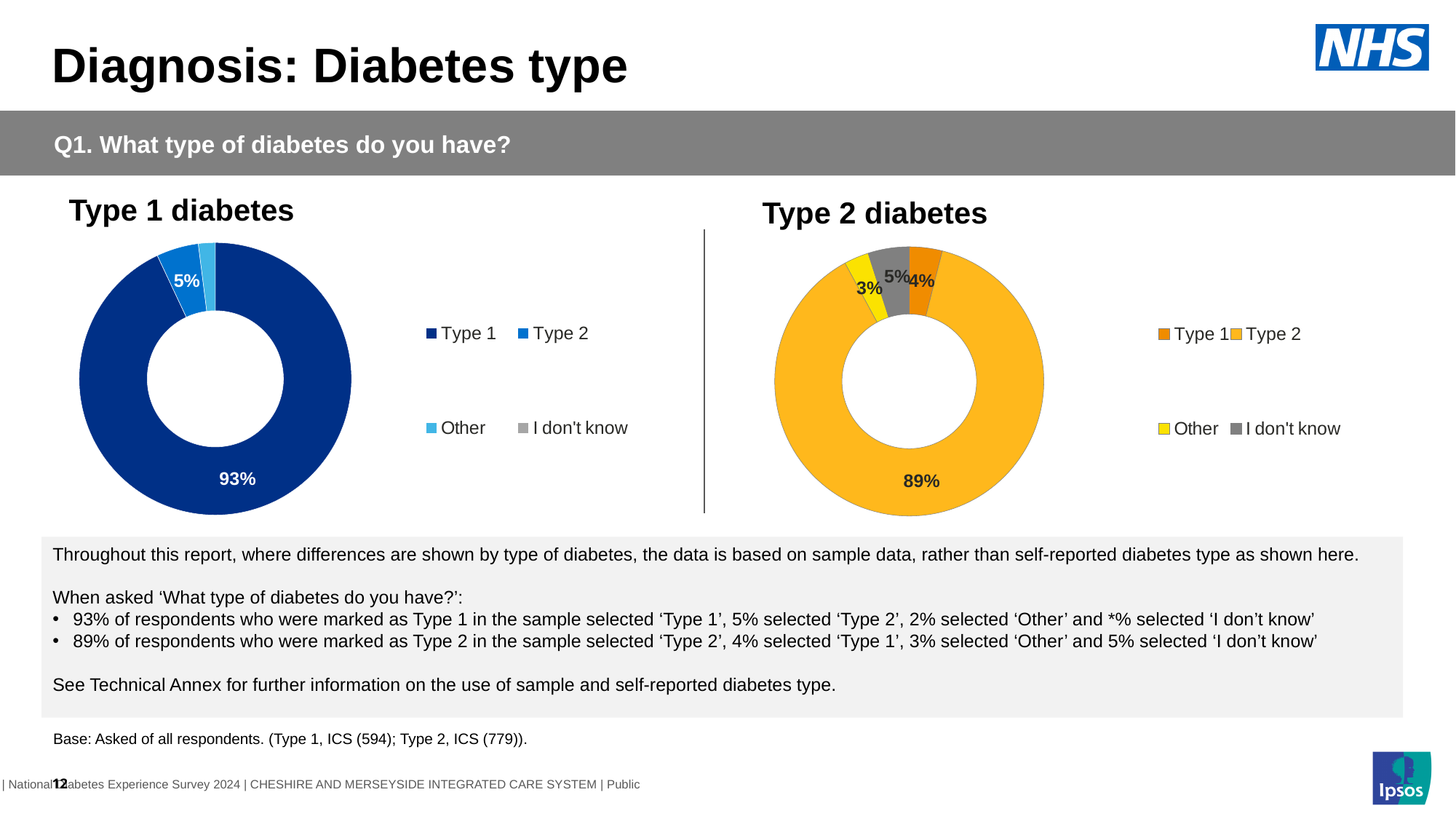
In the 'Type 2 diabetes' chart, what share of respondents selected 'I don't know'? 5% In the 'Type 2 diabetes' chart, which is larger: the share for 'I don't know' or the share for 'Other'? I don't know In the 'Type 2 diabetes' chart, what share of respondents selected 'Type 2'? 89% In the 'Type 1 diabetes' chart, what share of respondents selected 'Type 2'? 5% In the 'Type 1 diabetes' chart, what is the difference in percentage points between the 'Type 1' and 'Type 2' shares? 88 percentage points In the 'Type 2 diabetes' chart, which category has the smallest share? Other In the 'Type 1 diabetes' chart, which category has the largest share? Type 1 In the 'Type 1 diabetes' chart, what share of respondents selected 'Type 1'? 93% In the 'Type 2 diabetes' chart, what share of respondents selected 'Type 1'? 4% What kind of chart is used to show the 'Type 1 diabetes' data? Doughnut (pie) chart How many entries does the legend of the 'Type 2 diabetes' chart list? 4 In the 'Type 2 diabetes' chart, what share of respondents selected 'Other'? 3%